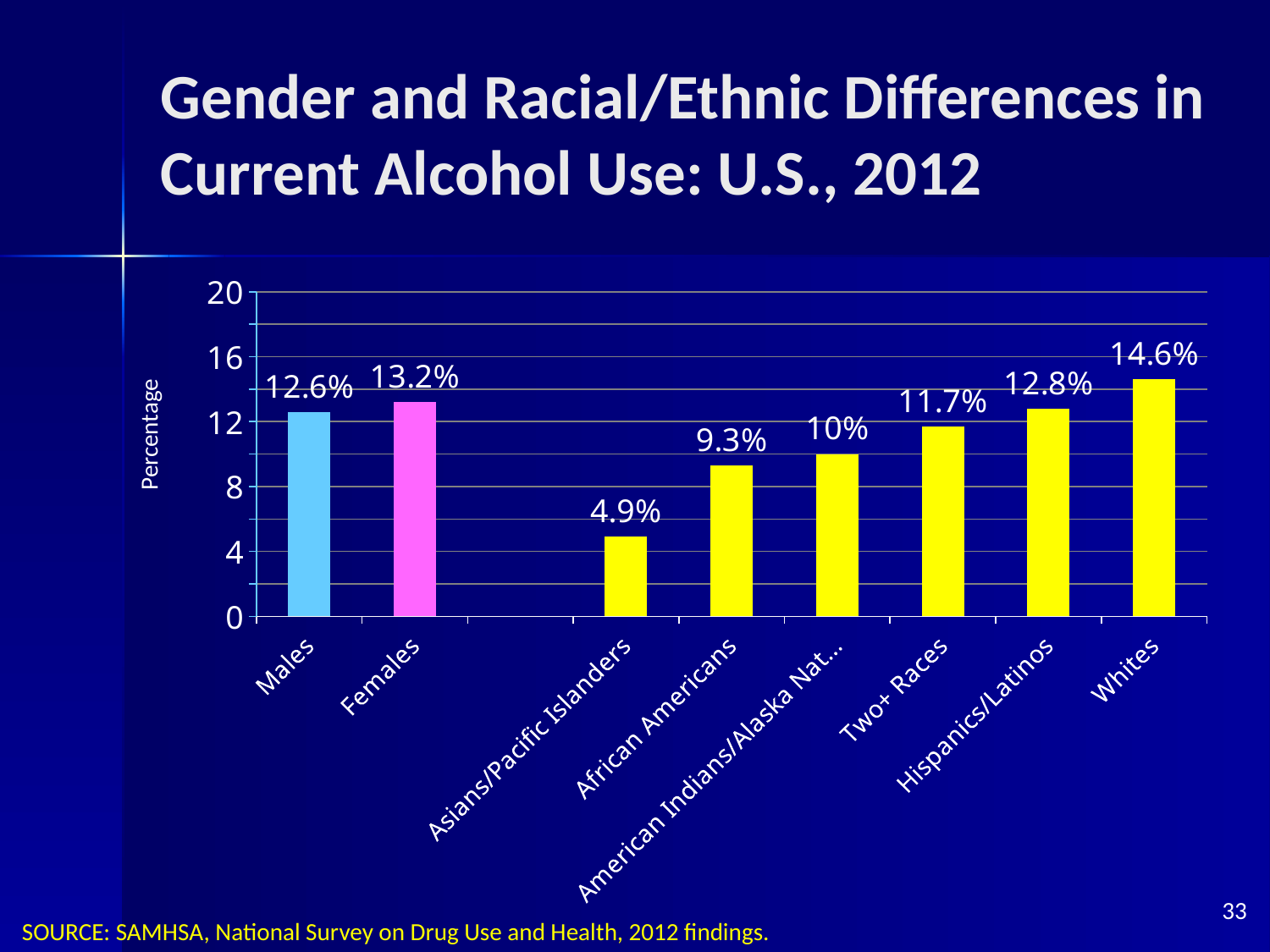
What kind of chart is shown on the slide? Bar chart What is the difference between the values for Females and Males? 0.6% What is the value for Asians/Pacific Islanders? 4.9% Which is larger, the value for Two+ Races or the value for African Americans? Two+ Races What is the value for Hispanics/Latinos? 12.8% What is the value for Females? 13.2% What is the label of the vertical axis? Percentage Which category has the lowest value? Asians/Pacific Islanders What is the difference between the values for Whites and Asians/Pacific Islanders? 9.7% What is the value for Males? 12.6% Which category has the highest value? Whites Is the value for African Americans greater or less than 8? greater